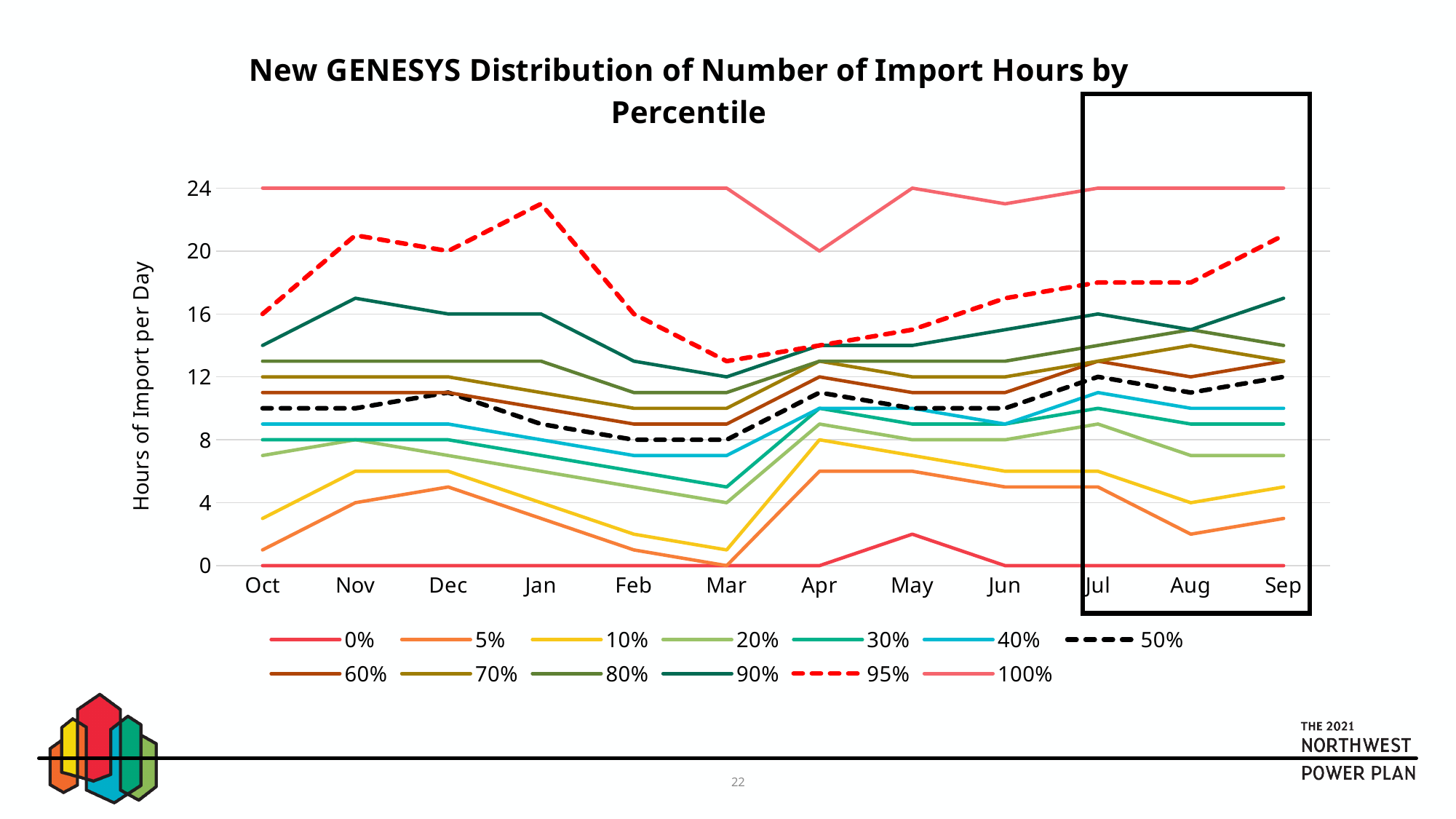
In which month does the 95% series reach its highest value? Jan In which month does the 100% series reach its lowest value? Apr What is the value of the 90% series in Jan? 16 What is the value of the 50% series in Sep? 12 What is the value of the 100% series in Apr? 20 What is the value of the 100% series in Oct? 24 What is the value of the 95% series in Dec? 20 How many months are shown along the x axis? 12 Which series is drawn as a black dashed line? 50% Is the value for the 95% series in Jan greater or less than 20? greater What type of chart is shown on the slide? line chart How many series does the legend list? 13